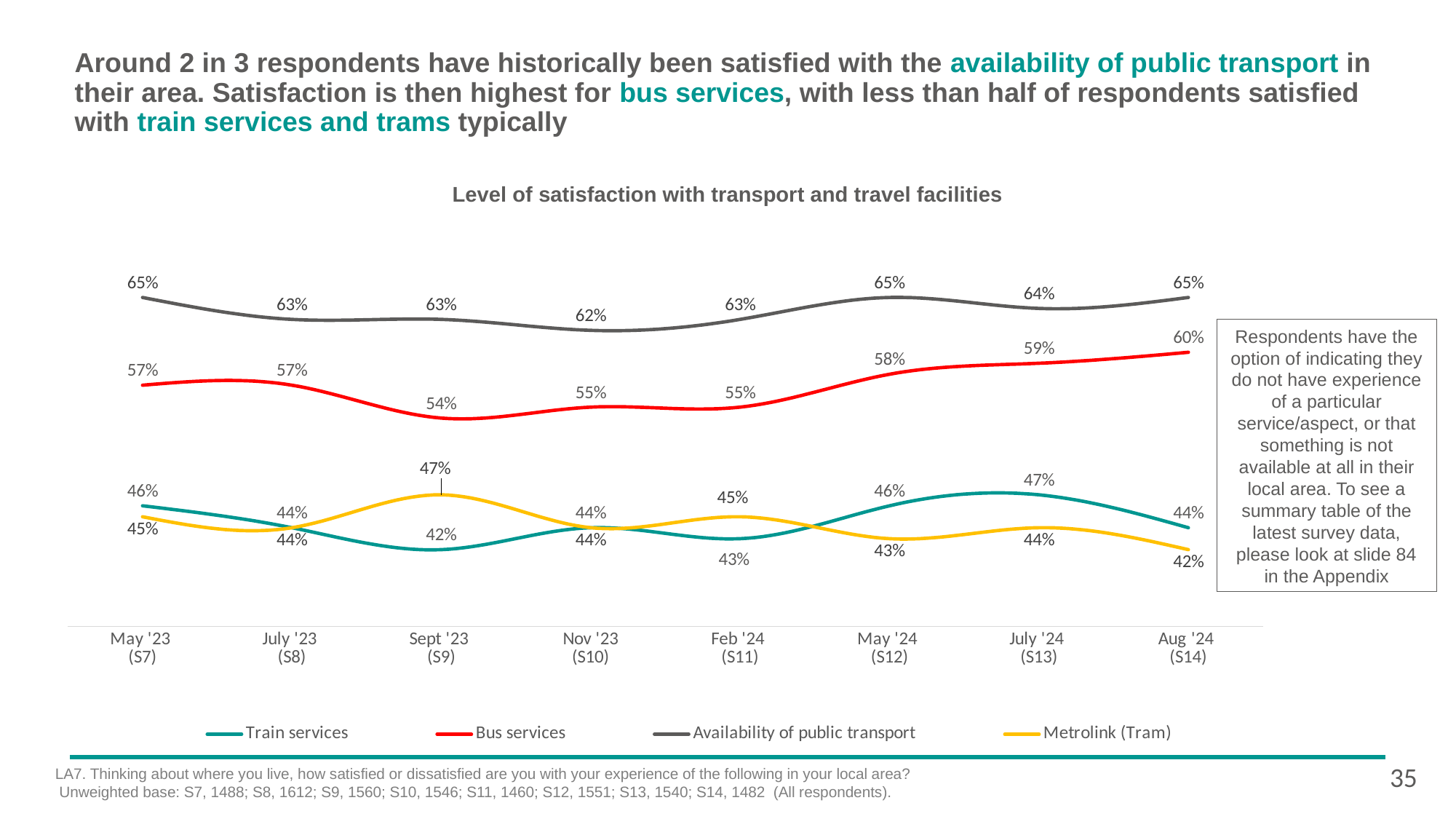
What is the value for Train services in Sept '23 (S9)? 42% In which survey wave is satisfaction with Bus services highest? Aug '24 (S14) How many survey waves are plotted along the x axis? 8 In Aug '24 (S14), what is the difference between Availability of public transport and Bus services? 5 percentage points In Sept '23 (S9), which is higher: Train services or Metrolink (Tram)? Metrolink (Tram) What is the value for Metrolink (Tram) in Sept '23 (S9)? 47% How many series does the legend list? 4 Does satisfaction with Bus services rise or fall from Sept '23 (S9) to Aug '24 (S14)? Rise What is the value for Bus services in Aug '24 (S14)? 60% In which survey wave is satisfaction with Availability of public transport lowest? Nov '23 (S10) What is the value for Availability of public transport in Nov '23 (S10)? 62% What kind of chart is shown on the slide? Line chart